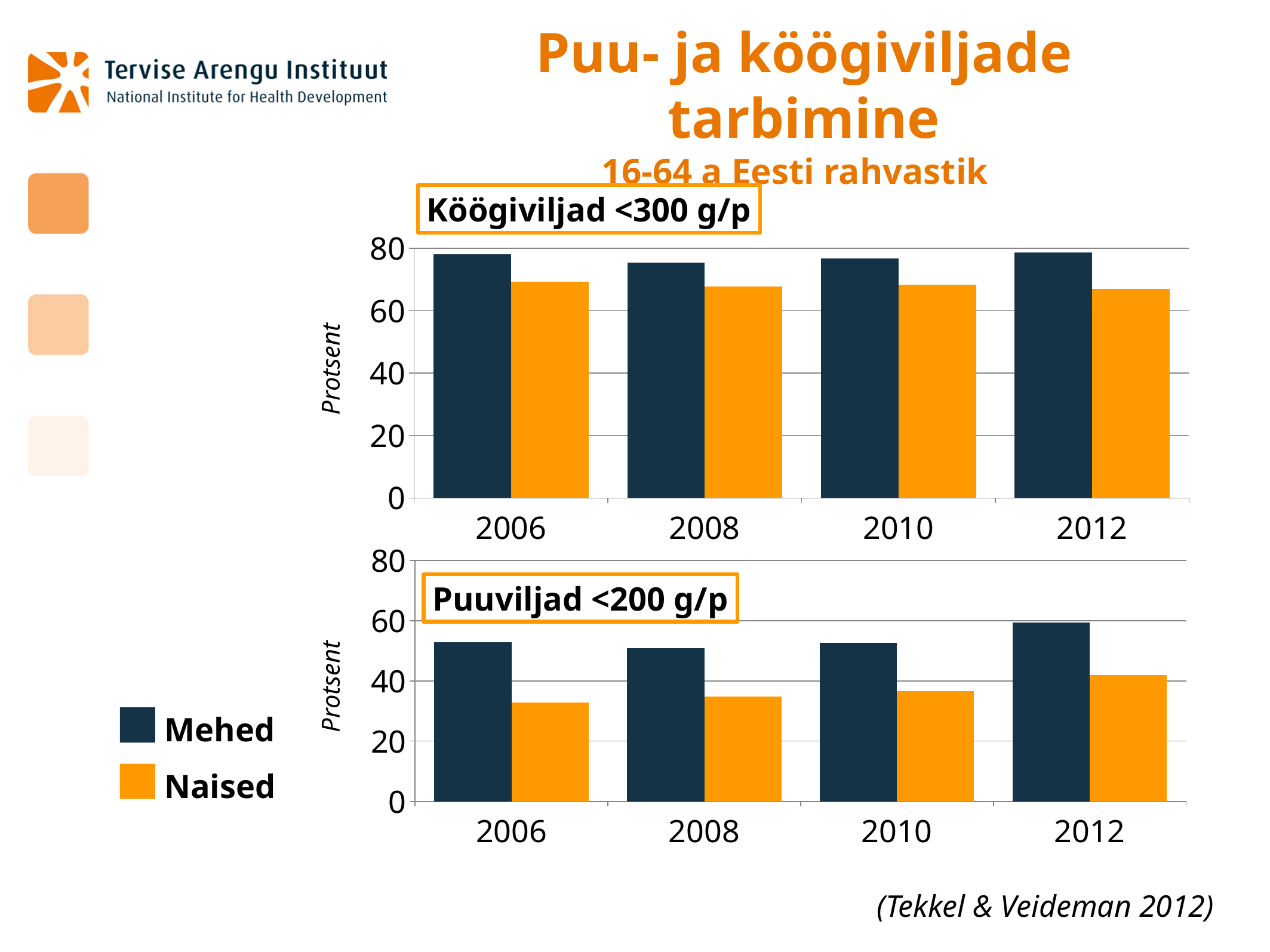
In the top chart "Köögiviljad <300 g/p", how many years are shown on the x axis? 4 In the bottom chart "Puuviljad <200 g/p", in which year is the Naised value highest? 2012 In the bottom chart "Puuviljad <200 g/p", is the value for Naised in 2006 greater or less than 40? less In the top chart "Köögiviljad <300 g/p", is the value for Naised in 2012 greater or less than 60? greater How many series does the legend list for the charts on the slide? 2 In the bottom chart "Puuviljad <200 g/p", in which year is the Naised value lowest? 2006 What is the label on the y axis of the charts on the slide? Protsent What kind of chart is the top chart titled "Köögiviljad <300 g/p"? bar chart In the top chart "Köögiviljad <300 g/p", is the value for Mehed in 2008 greater or less than 80? less In the bottom chart "Puuviljad <200 g/p", do the Naised values rise or fall from 2006 to 2012? rise In the bottom chart "Puuviljad <200 g/p", which is larger in 2012, Mehed or Naised? Mehed In the top chart "Köögiviljad <300 g/p", which is larger in 2006, Mehed or Naised? Mehed